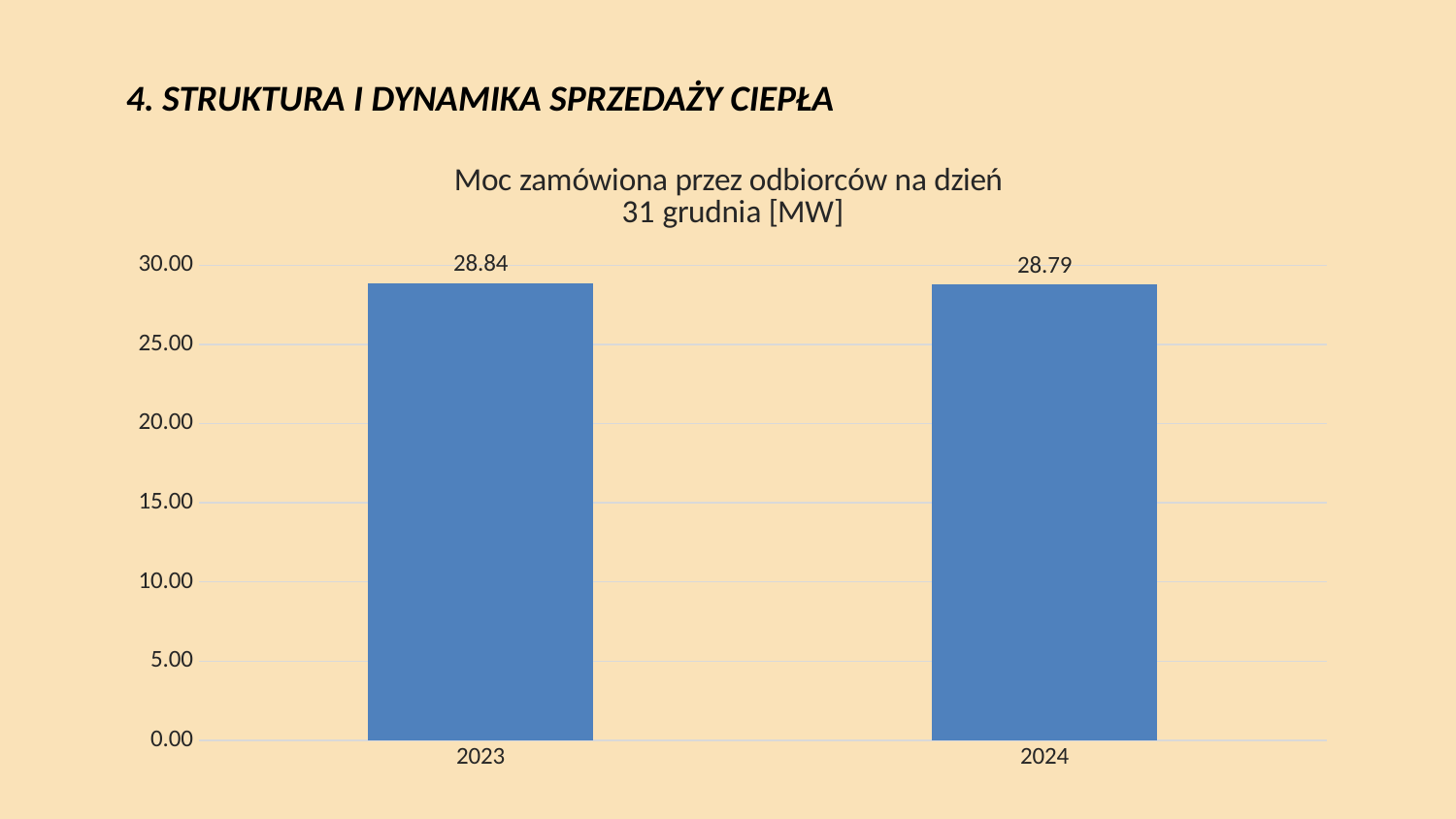
What is the title of the chart? Moc zamówiona przez odbiorców na dzień 31 grudnia [MW] Which year has the lower value according to the data labels? 2024 Which year has the higher value according to the data labels? 2023 What is the highest value shown on the y axis? 30.00 What is the difference between the values for 2023 and 2024? 0.05 What is the value for 2024? 28.79 What is the value for 2023? 28.84 Is the value for 2023 larger or smaller than the value for 2024? larger How many categories are shown on the x axis? 2 Do the values rise or fall from 2023 to 2024? fall What kind of chart is shown on the slide? bar chart Is the value for 2024 greater or less than 25.00? greater